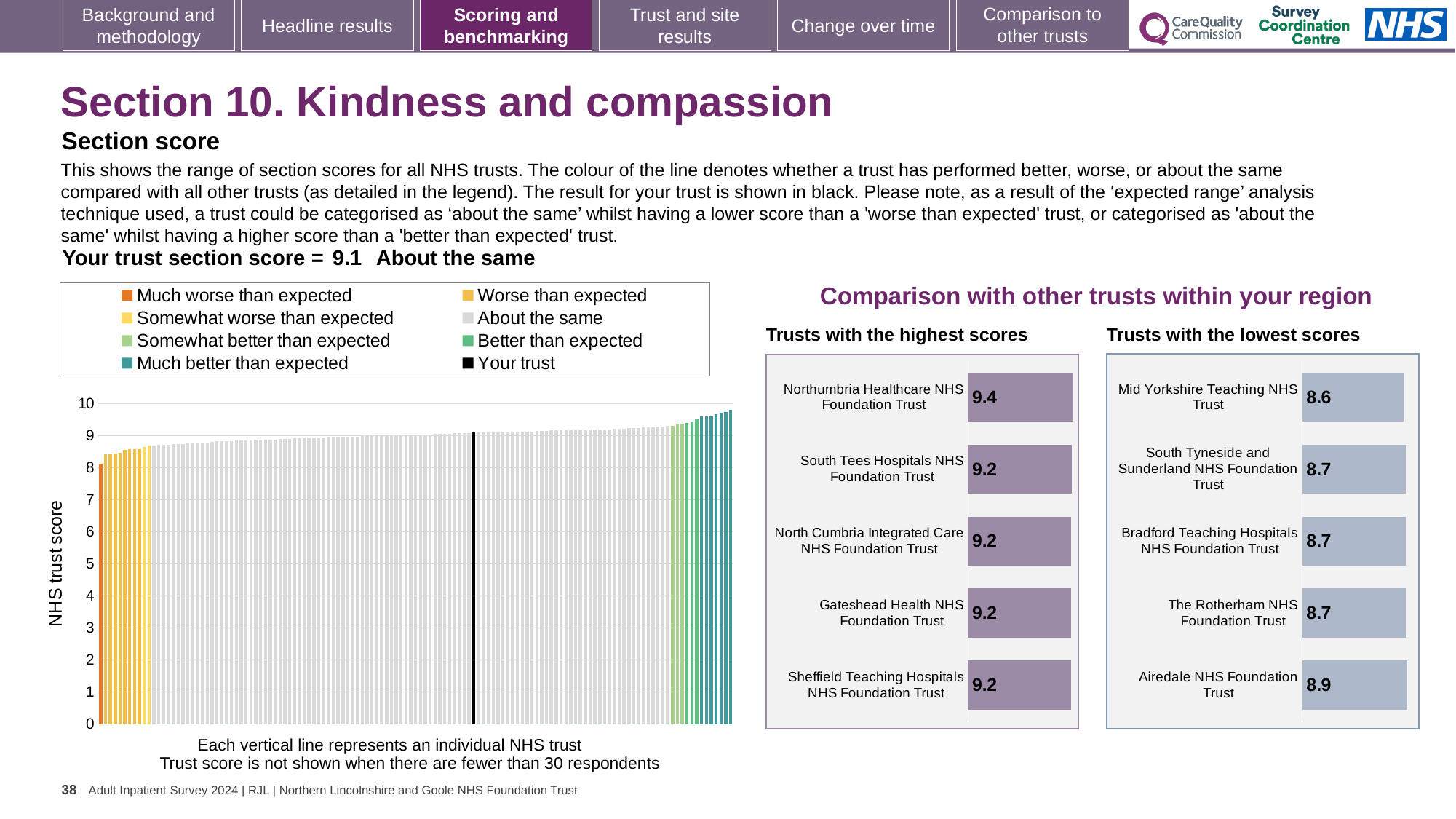
In the 'Trusts with the highest scores' chart, what is the score for Northumbria Healthcare NHS Foundation Trust? 9.4 How many trusts are listed in the 'Trusts with the highest scores' chart? 5 In the 'Trusts with the highest scores' chart, what is the difference between the scores of Northumbria Healthcare NHS Foundation Trust and Sheffield Teaching Hospitals NHS Foundation Trust? 0.2 How many entries does the legend of the main 'NHS trust score' chart list? 8 In the 'Trusts with the lowest scores' chart, which has the larger score: Airedale NHS Foundation Trust or Mid Yorkshire Teaching NHS Trust? Airedale NHS Foundation Trust What kind of chart is the main 'NHS trust score' chart on the left? bar chart In the 'Trusts with the lowest scores' chart, what is the score for Airedale NHS Foundation Trust? 8.9 In the main 'NHS trust score' chart on the left, is the value for the leftmost trust greater or less than 9? less In the main 'NHS trust score' chart on the left, do the values rise or fall from left to right? rise In the 'Trusts with the lowest scores' chart, which trust has the lowest score? Mid Yorkshire Teaching NHS Trust In the 'Trusts with the highest scores' chart, which trust has the highest score? Northumbria Healthcare NHS Foundation Trust In the 'Trusts with the lowest scores' chart, what is the difference between the scores of Airedale NHS Foundation Trust and Mid Yorkshire Teaching NHS Trust? 0.3